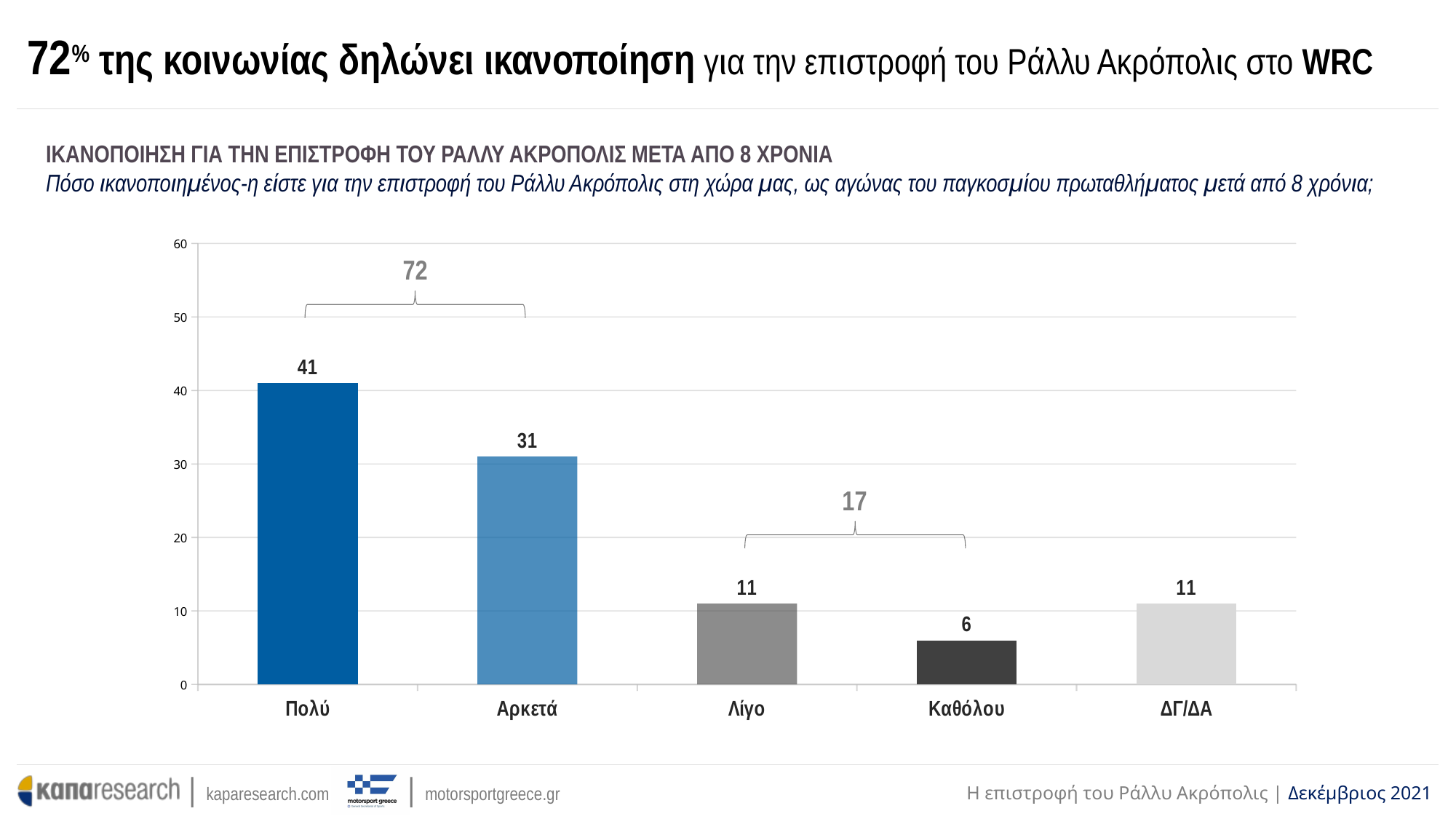
What is the difference between the values for Πολύ and Αρκετά? 10 What is the value for Καθόλου? 6 What is the value for ΔΓ/ΔΑ? 11 Which category has the highest value? Πολύ How many categories are shown on the x axis? 5 Which category has the lowest value? Καθόλου What kind of chart is shown on the slide? Bar chart What combined value is shown by the bracket above the Πολύ and Αρκετά bars? 72 What is the value for Αρκετά? 31 Which is larger, the value for Αρκετά or the value for Λίγο? Αρκετά What is the value for Πολύ? 41 What is the difference between the values for Λίγο and Καθόλου? 5